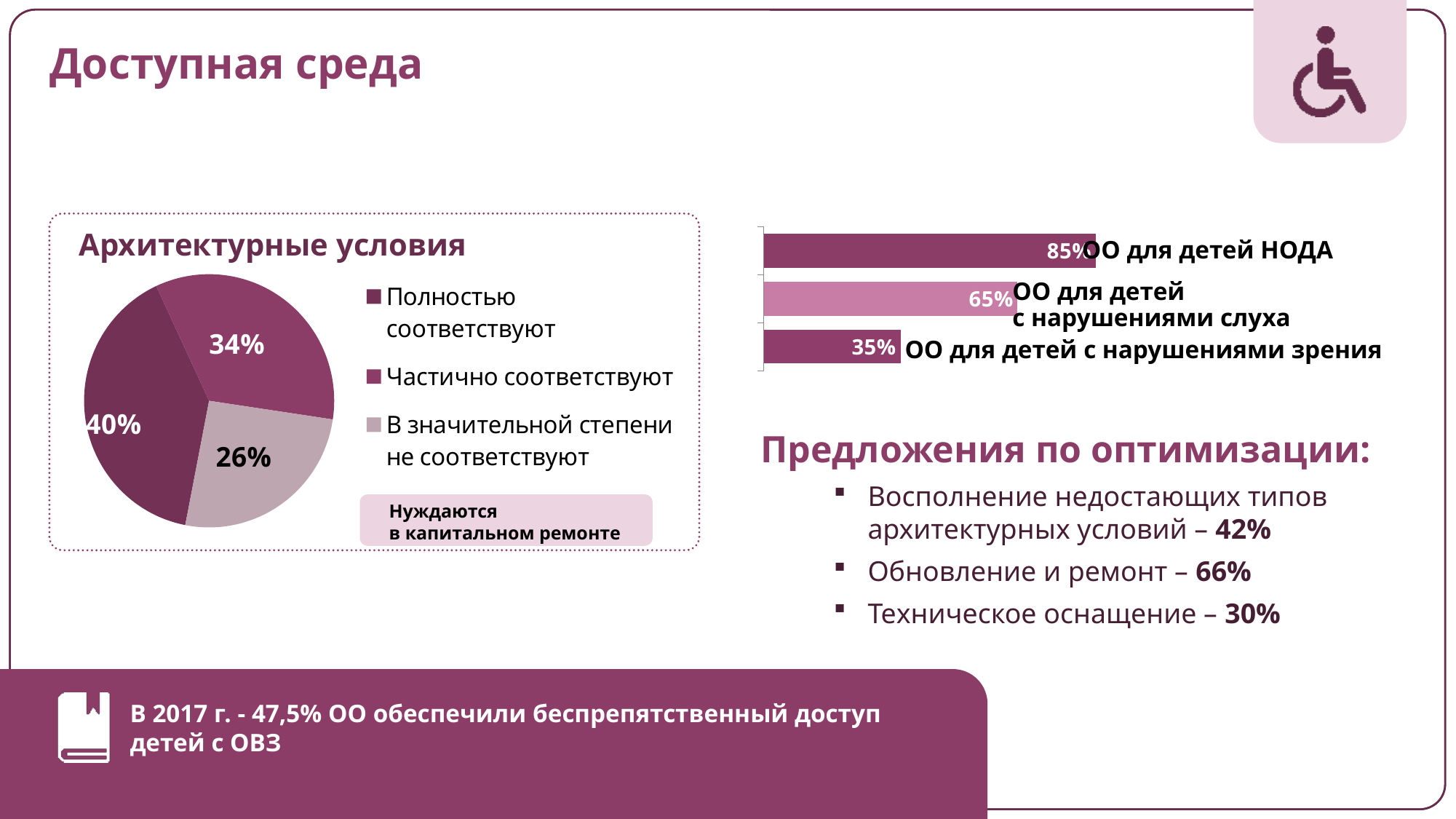
How many bars are in the bar chart on the right? 3 In the bar chart on the right, what is the value for ОО для детей с нарушениями зрения? 35% In the bar chart on the right, which is larger: the value for ОО для детей с нарушениями слуха or for ОО для детей с нарушениями зрения? ОО для детей с нарушениями слуха In the bar chart on the right, what is the value for ОО для детей НОДА? 85% What kind of chart is the chart titled Архитектурные условия? pie chart What kind of chart is the chart on the right of the slide? bar chart In the pie chart titled Архитектурные условия, what is the share of the largest slice? 40% In the bar chart on the right, what is the difference between the values for ОО для детей НОДА and ОО для детей с нарушениями зрения? 50% How many entries does the legend of the pie chart titled Архитектурные условия list? 3 In the bar chart on the right, what is the value for ОО для детей с нарушениями слуха? 65% In the bar chart on the right, which category has the highest value? ОО для детей НОДА In the bar chart on the right, which category has the lowest value? ОО для детей с нарушениями зрения